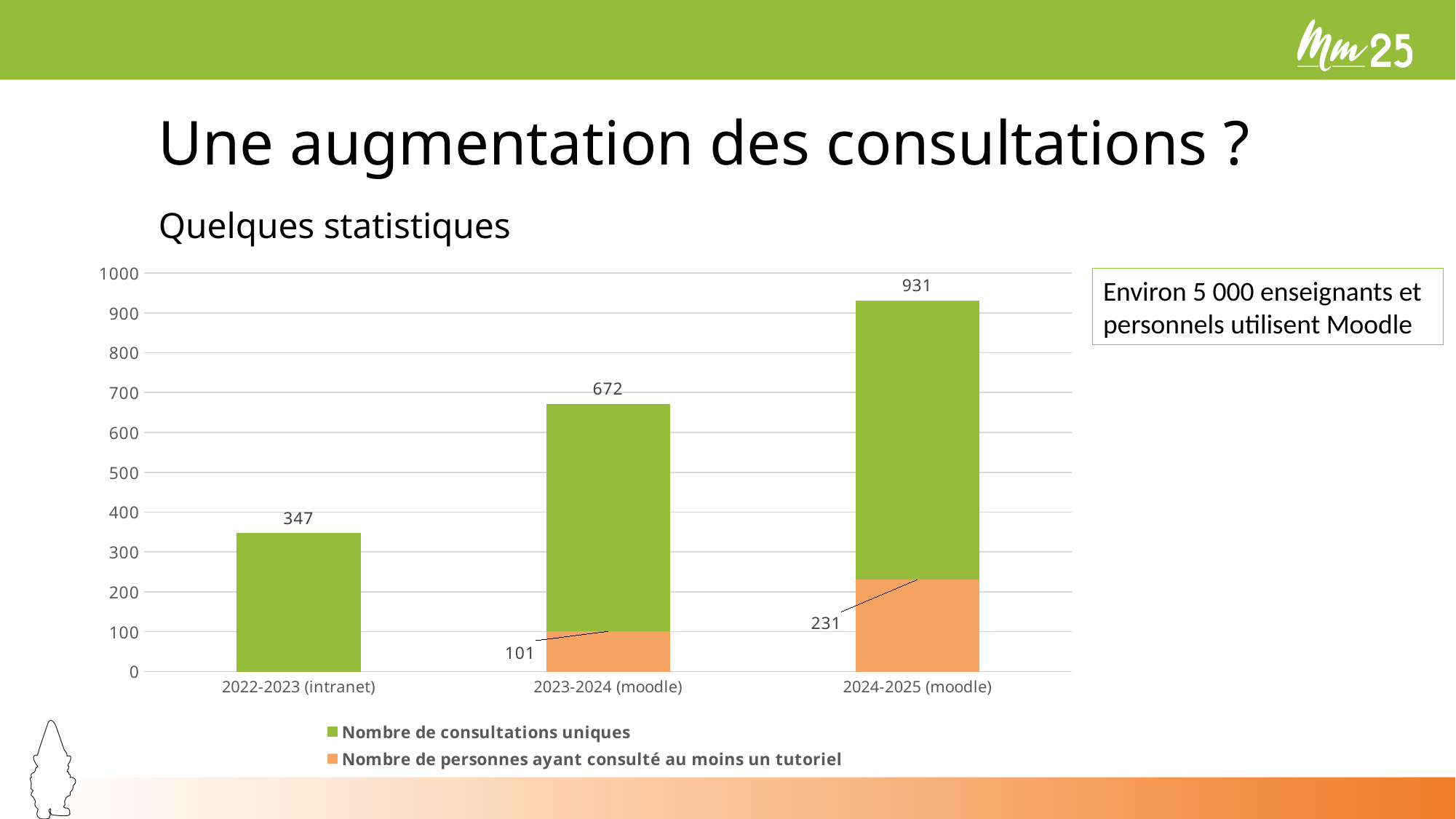
What is the value of 'Nombre de consultations uniques' for 2024-2025 (moodle)? 931 What is the value of 'Nombre de personnes ayant consulté au moins un tutoriel' for 2023-2024 (moodle)? 101 Which period has the highest value for 'Nombre de consultations uniques'? 2024-2025 (moodle) Does 'Nombre de consultations uniques' rise or fall from 2022-2023 to 2024-2025? rise How many series does the chart legend list? 2 Which is larger: 'Nombre de consultations uniques' for 2023-2024 (moodle) or for 2022-2023 (intranet)? 2023-2024 (moodle) Which period has the lowest value for 'Nombre de consultations uniques'? 2022-2023 (intranet) What is the value of 'Nombre de personnes ayant consulté au moins un tutoriel' for 2024-2025 (moodle)? 231 What is the difference in 'Nombre de consultations uniques' between 2024-2025 (moodle) and 2023-2024 (moodle)? 259 What is the value of 'Nombre de consultations uniques' for 2022-2023 (intranet)? 347 What is the difference in 'Nombre de personnes ayant consulté au moins un tutoriel' between 2024-2025 (moodle) and 2023-2024 (moodle)? 130 How many periods are shown on the x axis of the chart? 3